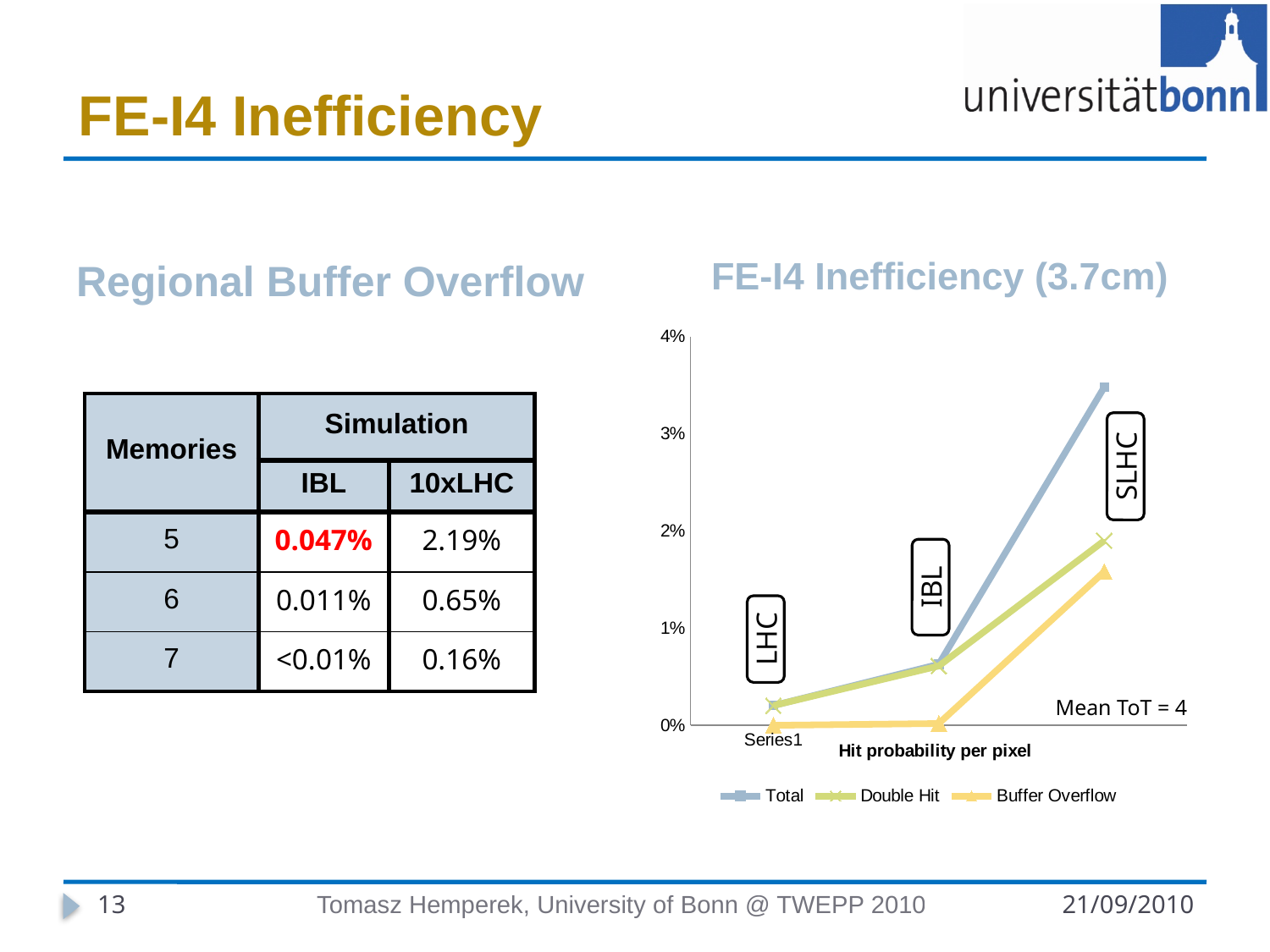
In the FE-I4 Inefficiency (3.7cm) chart, which series has the lowest value at SLHC? Buffer Overflow In the FE-I4 Inefficiency (3.7cm) chart, does the Total series rise or fall from LHC to SLHC? rise What Mean ToT value is annotated on the FE-I4 Inefficiency (3.7cm) chart? Mean ToT = 4 In the FE-I4 Inefficiency (3.7cm) chart, is the Total value at SLHC greater or less than 3%? greater How many series does the legend of the FE-I4 Inefficiency (3.7cm) chart list? 3 In the FE-I4 Inefficiency (3.7cm) chart, is the Buffer Overflow value at SLHC greater or less than 2%? less What kind of chart is shown under the title "FE-I4 Inefficiency (3.7cm)"? line chart How many labelled points (LHC, IBL, SLHC) are plotted along the x axis of the FE-I4 Inefficiency (3.7cm) chart? 3 In the FE-I4 Inefficiency (3.7cm) chart, which series has the highest value at SLHC? Total In the FE-I4 Inefficiency (3.7cm) chart, is the Total value at IBL greater or less than 1%? less In the FE-I4 Inefficiency (3.7cm) chart, which is larger at SLHC: Double Hit or Buffer Overflow? Double Hit What is the x-axis title of the FE-I4 Inefficiency (3.7cm) chart? Hit probability per pixel